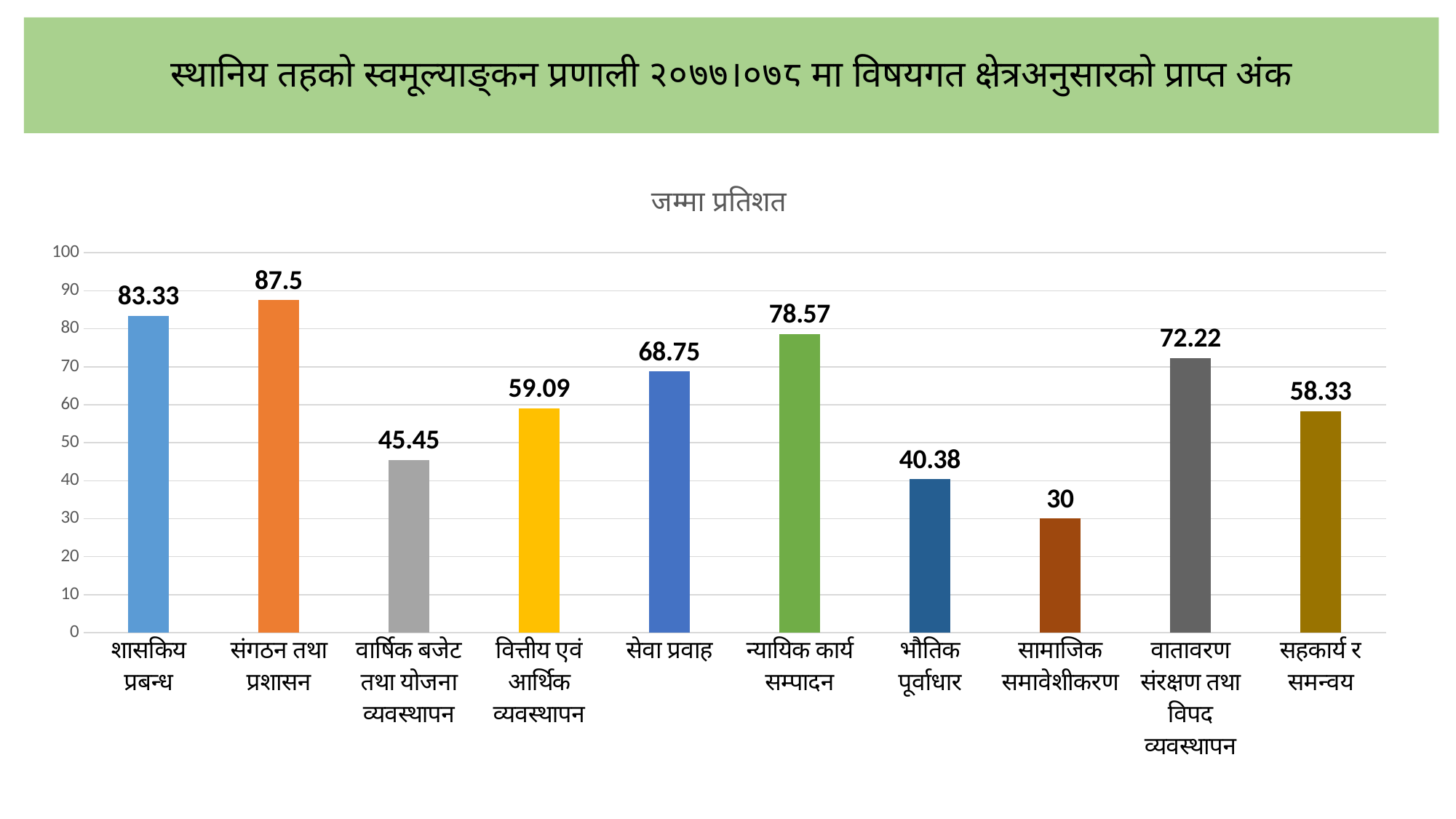
What is the value for संगठन तथा प्रशासन? 87.5 What is the title of the chart? जम्मा प्रतिशत What is the value for सामाजिक समावेशीकरण? 30 What kind of chart is shown on the slide? bar chart Which category has the lowest value? सामाजिक समावेशीकरण What is the difference between the values for शासकिय प्रबन्ध and सेवा प्रवाह? 14.58 Which is larger, the value for वित्तीय एवं आर्थिक व्यवस्थापन or the value for सहकार्य र समन्वय? वित्तीय एवं आर्थिक व्यवस्थापन What is the value for भौतिक पूर्वाधार? 40.38 Is the value for न्यायिक कार्य सम्पादन greater or less than 70? greater Which category has the highest value? संगठन तथा प्रशासन How many categories are shown in the chart? 10 What is the value for वातावरण संरक्षण तथा विपद व्यवस्थापन? 72.22